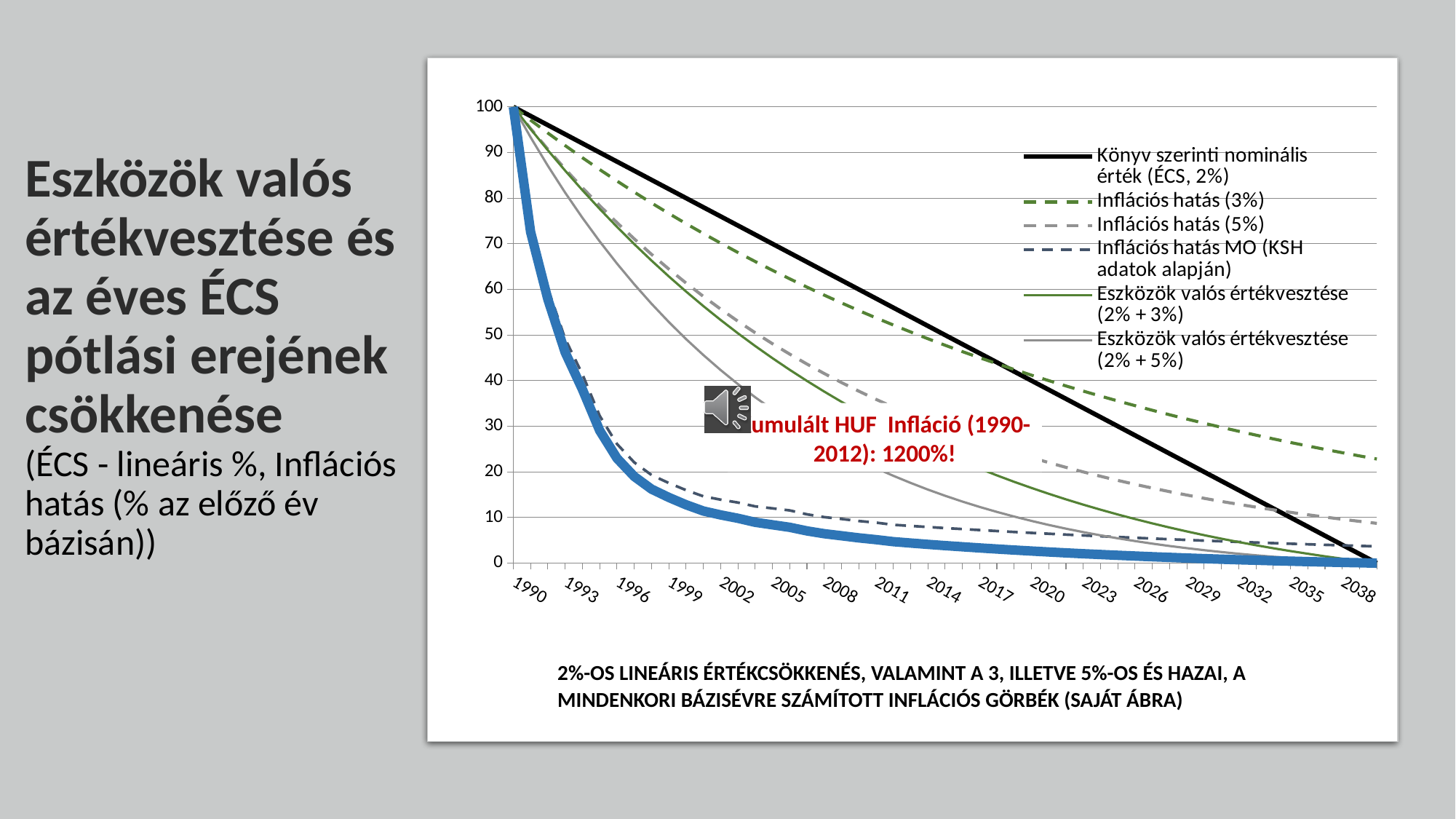
How many year labels are shown on the x axis of the chart? 17 Is the value of Inflációs hatás (3%) in 2038 greater or less than 20? greater Which series has the highest value in 2038? Inflációs hatás (3%) In 2020, which is larger: Inflációs hatás (3%) or Inflációs hatás (5%)? Inflációs hatás (3%) What value do all the series start at in 1990? 100 What is the first year shown on the x axis of the chart? 1990 What kind of chart is shown on the slide? line chart What is the last year labelled on the x axis of the chart? 2038 What cumulative HUF inflation figure for 1990-2012 is annotated on the chart? 1200% How many series does the chart legend list? 6 Do the series values rise or fall as the years increase along the x axis? fall